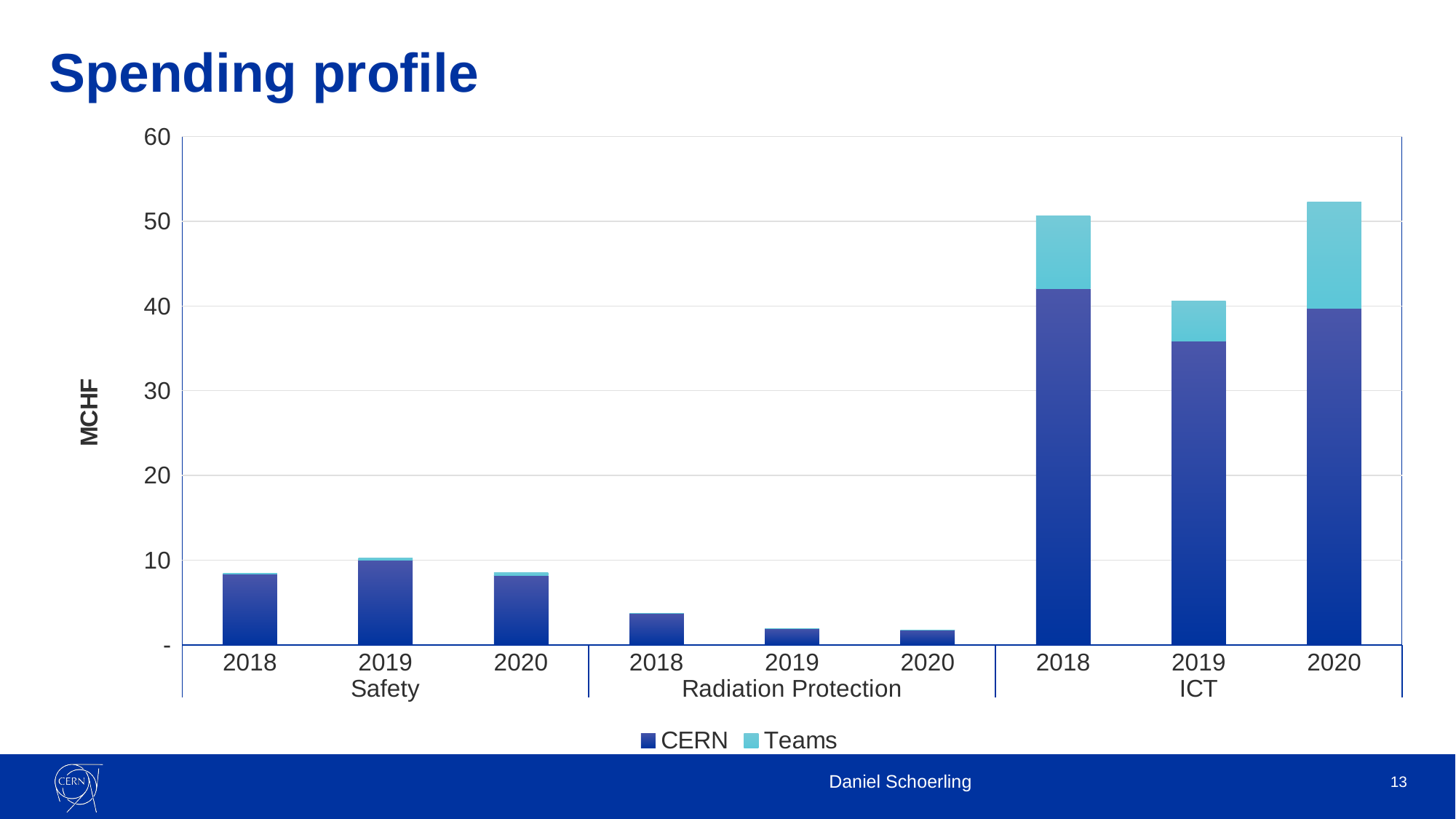
Which group has the shortest bars: Safety, Radiation Protection or ICT? Radiation Protection Which group has the tallest bars: Safety, Radiation Protection or ICT? ICT What is the label of the vertical axis? MCHF Is the total value for ICT in 2018 greater or less than 50? greater Which is larger, the total for ICT in 2020 or the total for ICT in 2019? ICT in 2020 What are the two series named in the legend? CERN and Teams Is the total value for Radiation Protection in 2018 greater or less than 10? less What kind of chart is shown on the slide? stacked bar chart How many bars are plotted in the chart? 9 Is the total value for ICT in 2019 greater or less than 50? less How many series does the legend list? 2